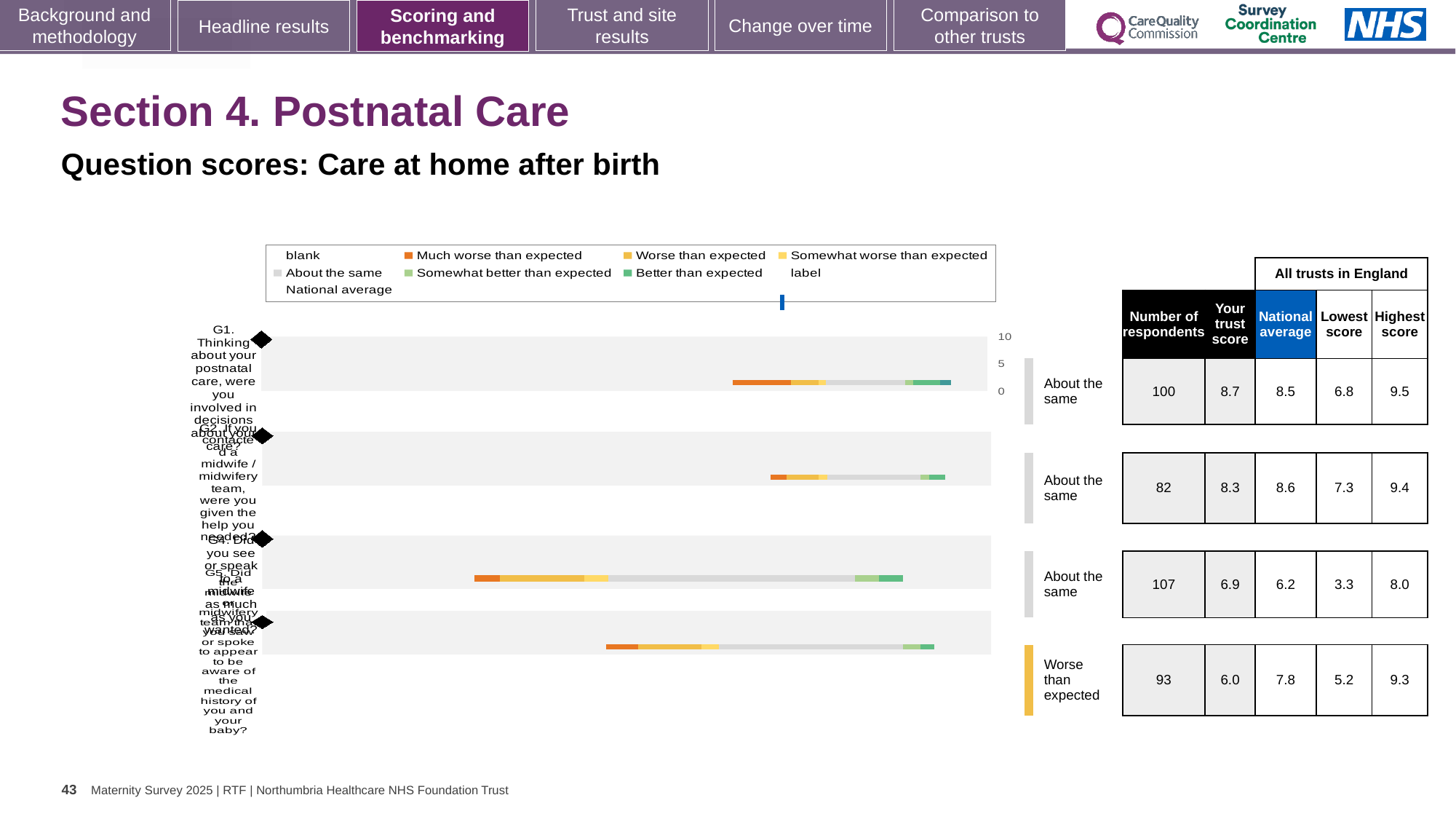
What kind of chart is shown on the slide? bar chart For the first row (G1), what is the difference between the trust score and the national average? 0.2 For the third row, is the trust score or the national average larger? the trust score (6.9) Which row in the table has the lowest 'Your trust score'? the fourth row (6.0) What is the national average for the fourth (bottom) row in the table? 7.8 What is the subtitle describing the chart on this slide? Question scores: Care at home after birth What is the highest score across all trusts in England for the first row (G1)? 9.5 What is the 'Your trust score' value for the first row (G1) in the table? 8.7 In the table beside the chart, what is the number of respondents for the first row (G1)? 100 How many question bars are plotted in the chart? 4 Which row in the table has the highest number of respondents? the third row (107) What benchmark category is shown for the fourth (bottom) row? Worse than expected